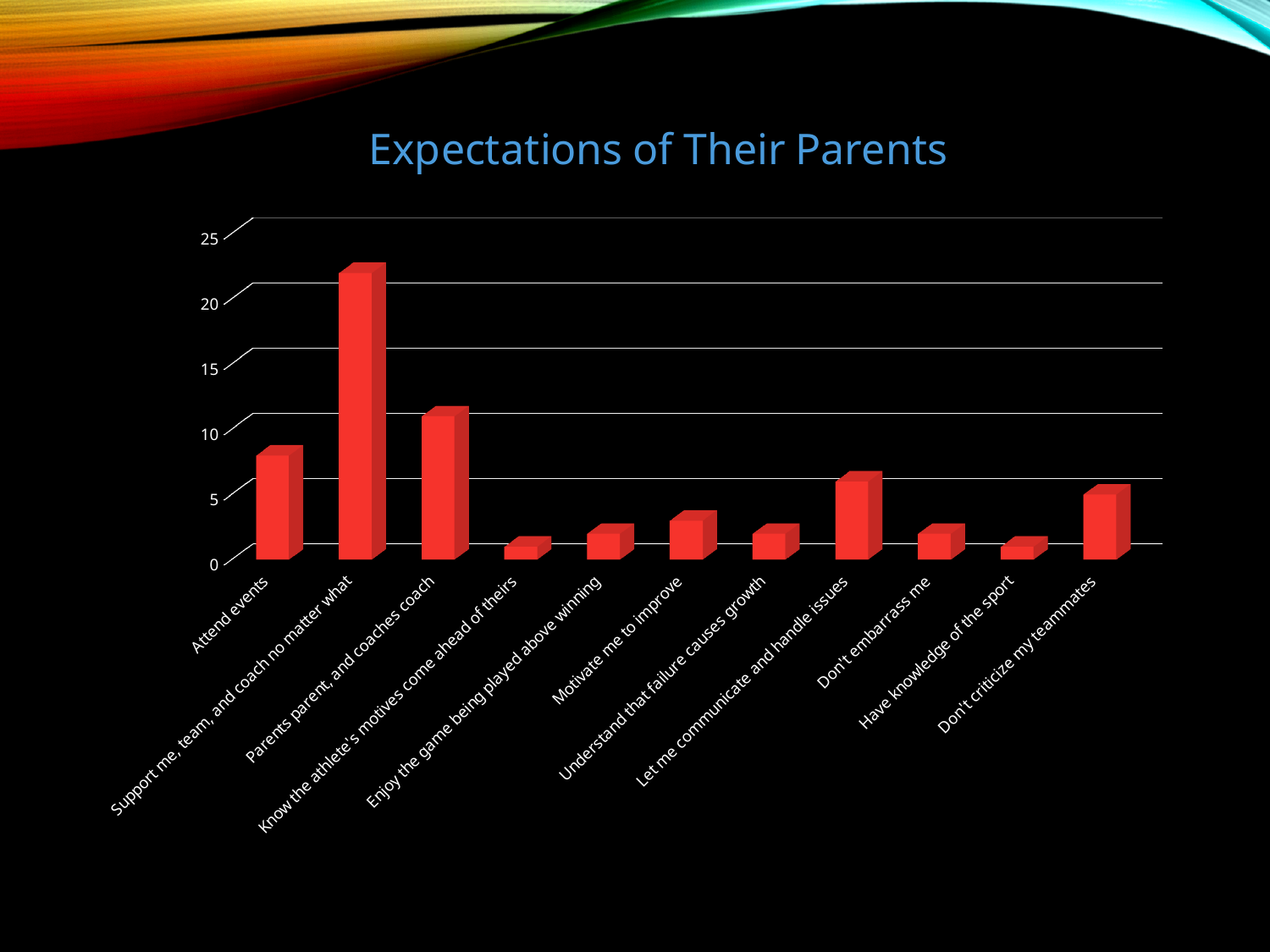
What is the title of the chart? Expectations of Their Parents Is the value for "Motivate me to improve" greater or less than 5? less Is the value for "Attend events" greater or less than 5? greater Is the value for "Know the athlete's motives come ahead of theirs" greater or less than 5? less What kind of chart is shown on the slide? bar chart How many categories are shown on the x axis of the chart? 11 Which category has the highest value? Support me, team, and coach no matter what Which is larger, the value for "Let me communicate and handle issues" or the value for "Motivate me to improve"? Let me communicate and handle issues What colour are the bars in the chart? red Which is larger, the value for "Attend events" or the value for "Parents parent, and coaches coach"? Parents parent, and coaches coach